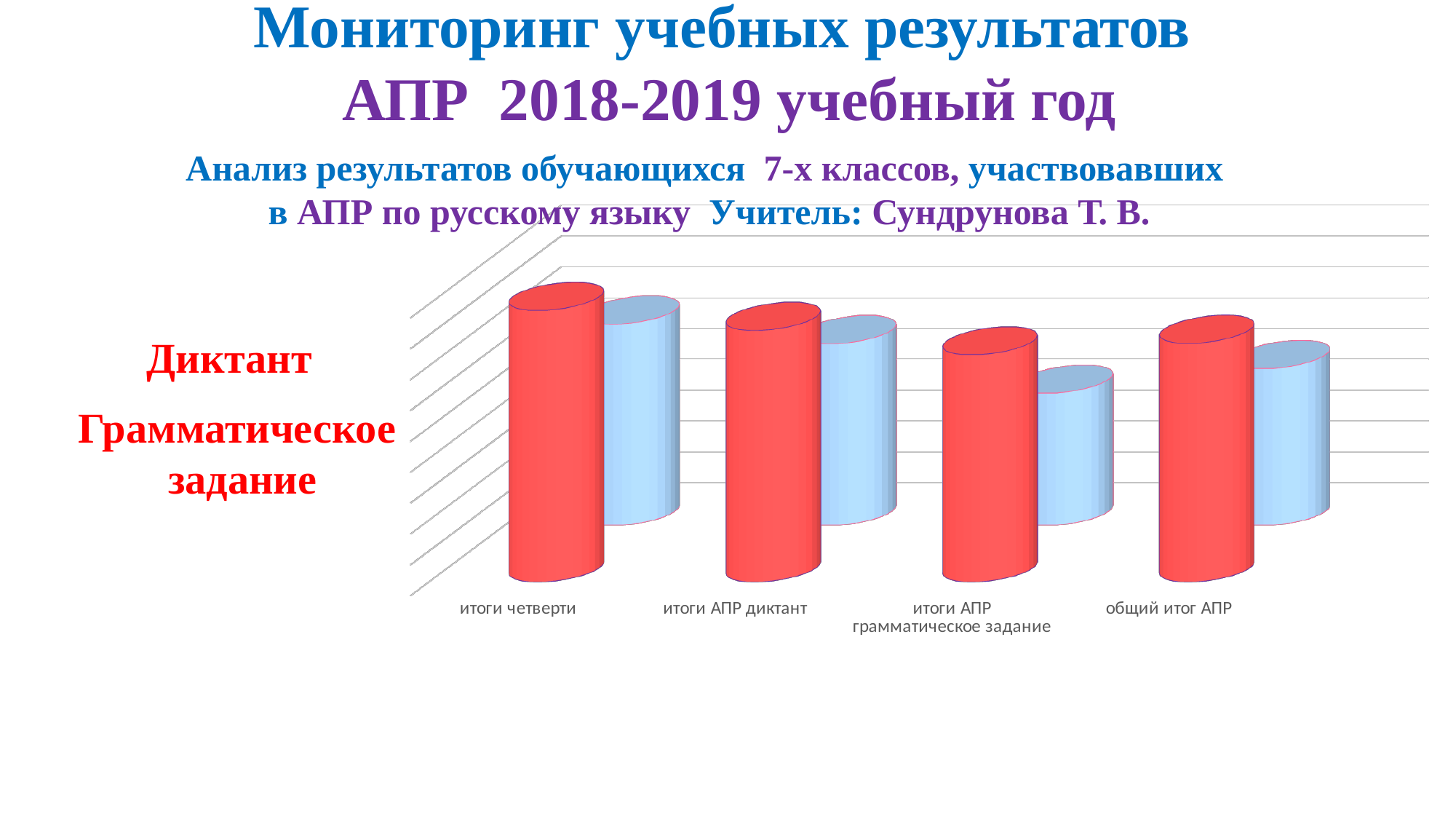
What kind of chart is shown on the slide? bar chart How many categories are shown along the x axis of the chart? 4 Which category has the shortest blue bar? итоги АПР грамматическое задание What two colours are used for the bars in the chart? red and light blue Which is taller: the red bar for 'итоги четверти' or the red bar for 'итоги АПР грамматическое задание'? итоги четверти How many bars are shown for each category in the chart? 2 How many bars are plotted in the chart in total? 8 In the category 'общий итог АПР', which bar is taller, the red one or the blue one? the red one Which category has the tallest red bar? итоги четверти What is the label of the last category on the x axis? общий итог АПР Which category has the shortest red bar? итоги АПР грамматическое задание In the category 'итоги АПР грамматическое задание', which bar is taller, the red one or the blue one? the red one